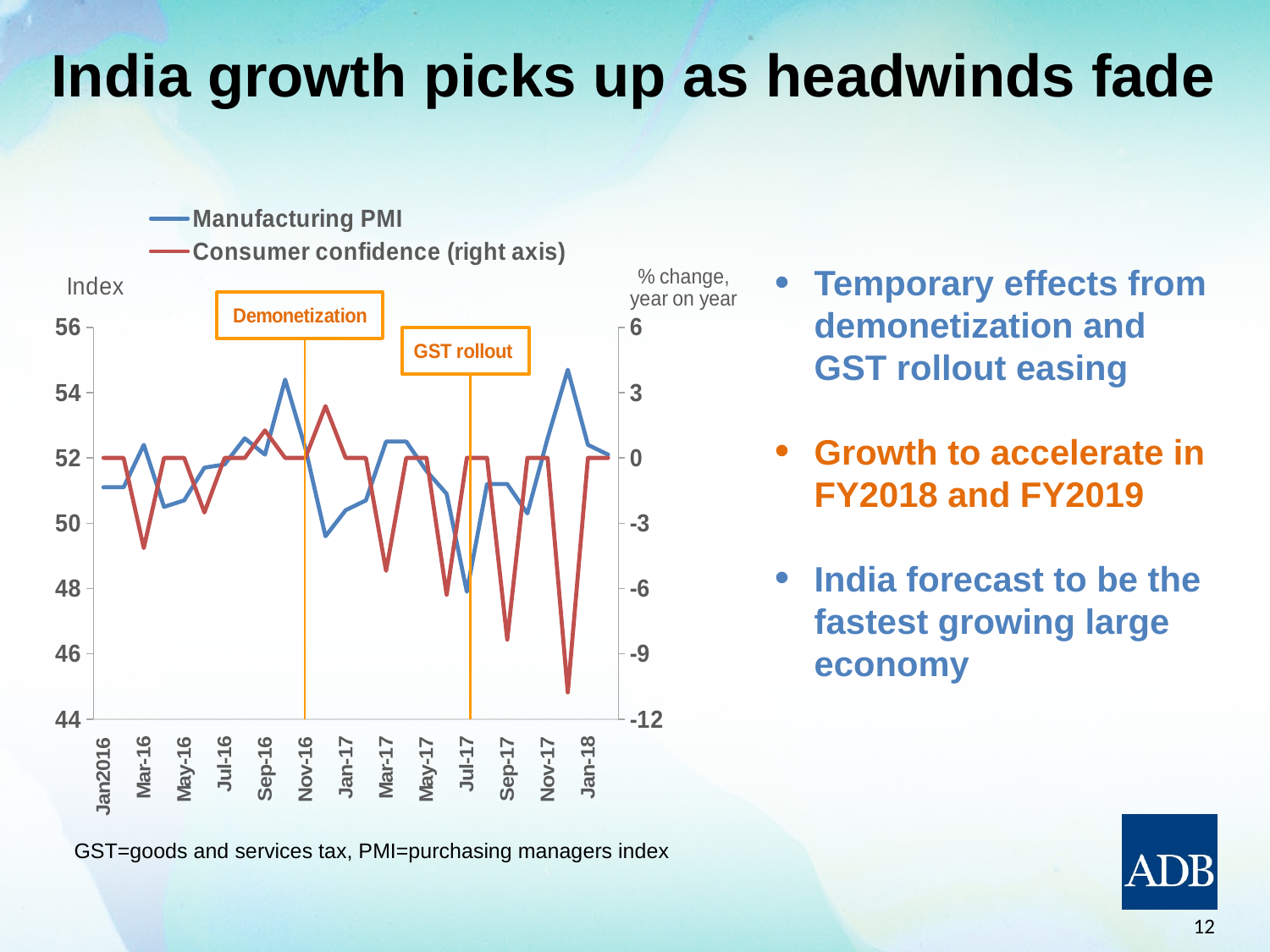
What kind of chart is shown on the slide? Line chart What is the title of the left vertical axis? Index Which series is plotted on the right axis according to the legend? Consumer confidence Is the Manufacturing PMI value for Jan-18 greater or less than 50? greater Is the Consumer confidence value for Sep-17 greater or less than -6? less How many series does the chart legend list? 2 How many month labels are shown along the x axis? 13 Which is larger, the Manufacturing PMI value for Nov-17 or for Jul-17? Nov-17 Is the Consumer confidence value for Nov-17 greater or less than -9? greater At which labelled month does the Manufacturing PMI line reach its lowest point? Jul-17